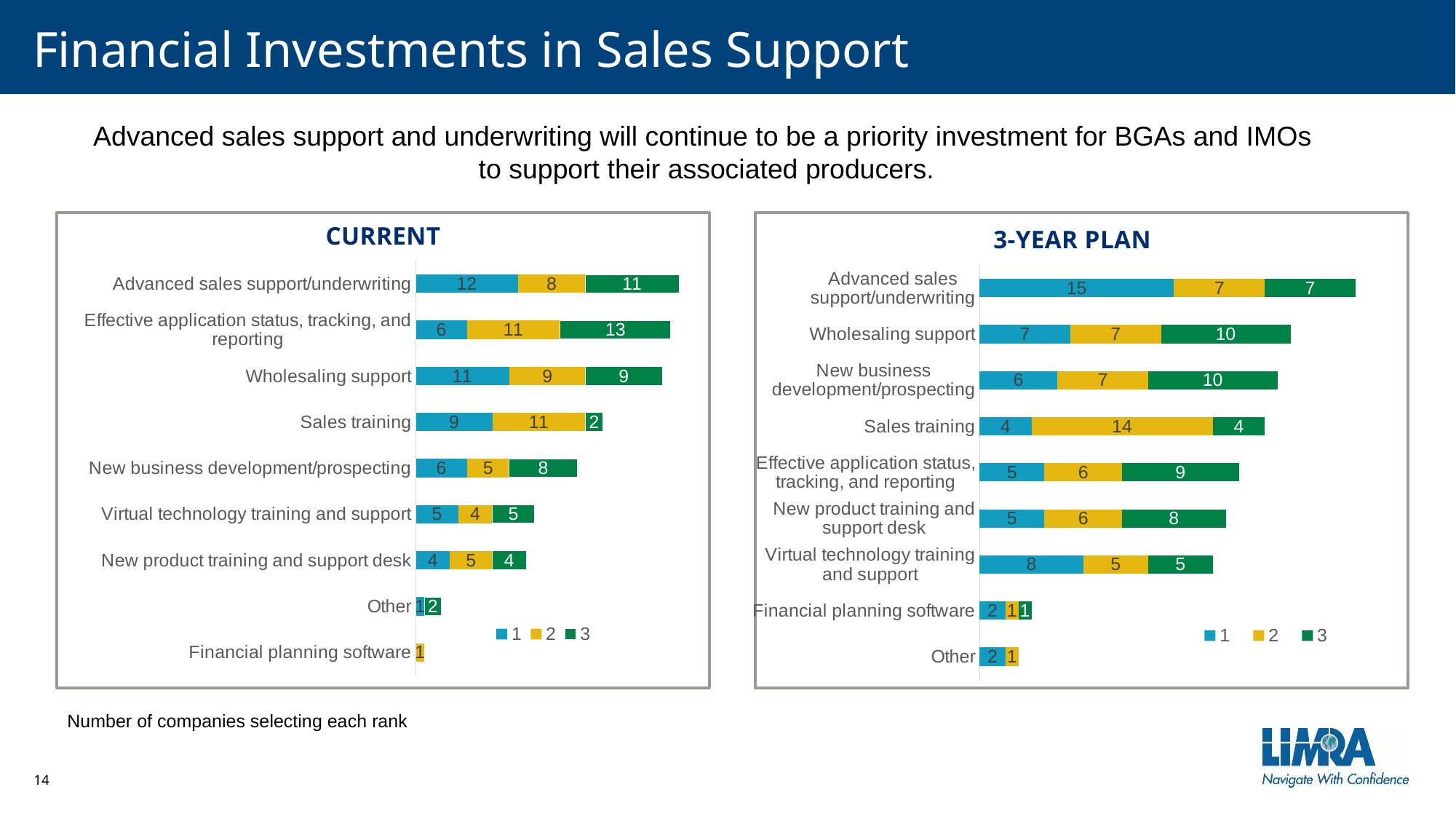
In the 3-YEAR PLAN chart, what is the difference between the rank 3 values for Wholesaling support and Sales training? 6 In the CURRENT chart, how many companies ranked Advanced sales support/underwriting as 1? 12 In the CURRENT chart, which category has the smallest total bar? Financial planning software What type of chart is the CURRENT chart? Stacked bar chart In the 3-YEAR PLAN chart, what is the value for rank 2 for Sales training? 14 How many series does the legend of the CURRENT chart list? 3 How many categories are shown in the 3-YEAR PLAN chart? 9 In the CURRENT chart, what is the total of the stacked bar for Advanced sales support/underwriting? 31 In the 3-YEAR PLAN chart, which category has the largest rank 1 value? Advanced sales support/underwriting In the CURRENT chart, what is the value for rank 3 for Effective application status, tracking, and reporting? 13 In the 3-YEAR PLAN chart, what is the total of the stacked bar for Wholesaling support? 24 In the CURRENT chart, is the rank 1 value for Wholesaling support larger or smaller than the rank 1 value for Sales training? larger